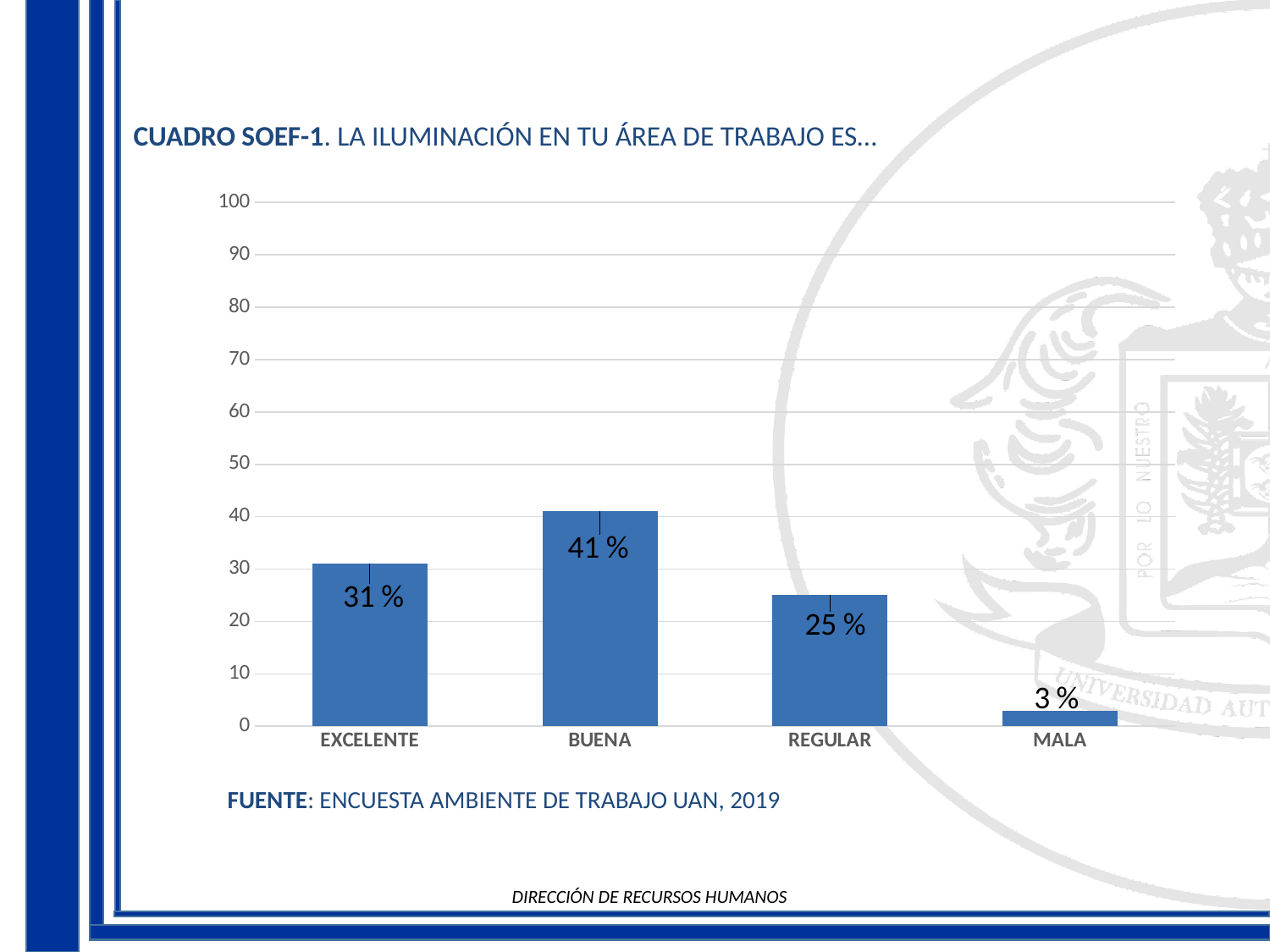
Which is larger, the value for EXCELENTE or the value for REGULAR? EXCELENTE How many categories are shown on the x axis? 4 What is the difference between the values for BUENA and EXCELENTE? 10 % What is the value for EXCELENTE? 31 % What is the value for REGULAR? 25 % What is the title of the chart? CUADRO SOEF-1. LA ILUMINACIÓN EN TU ÁREA DE TRABAJO ES… Which category has the highest value? BUENA Which category has the lowest value? MALA Is the value for REGULAR greater or less than 30? less What kind of chart is shown on the slide? bar chart What is the value for MALA? 3 % What is the value for BUENA? 41 %